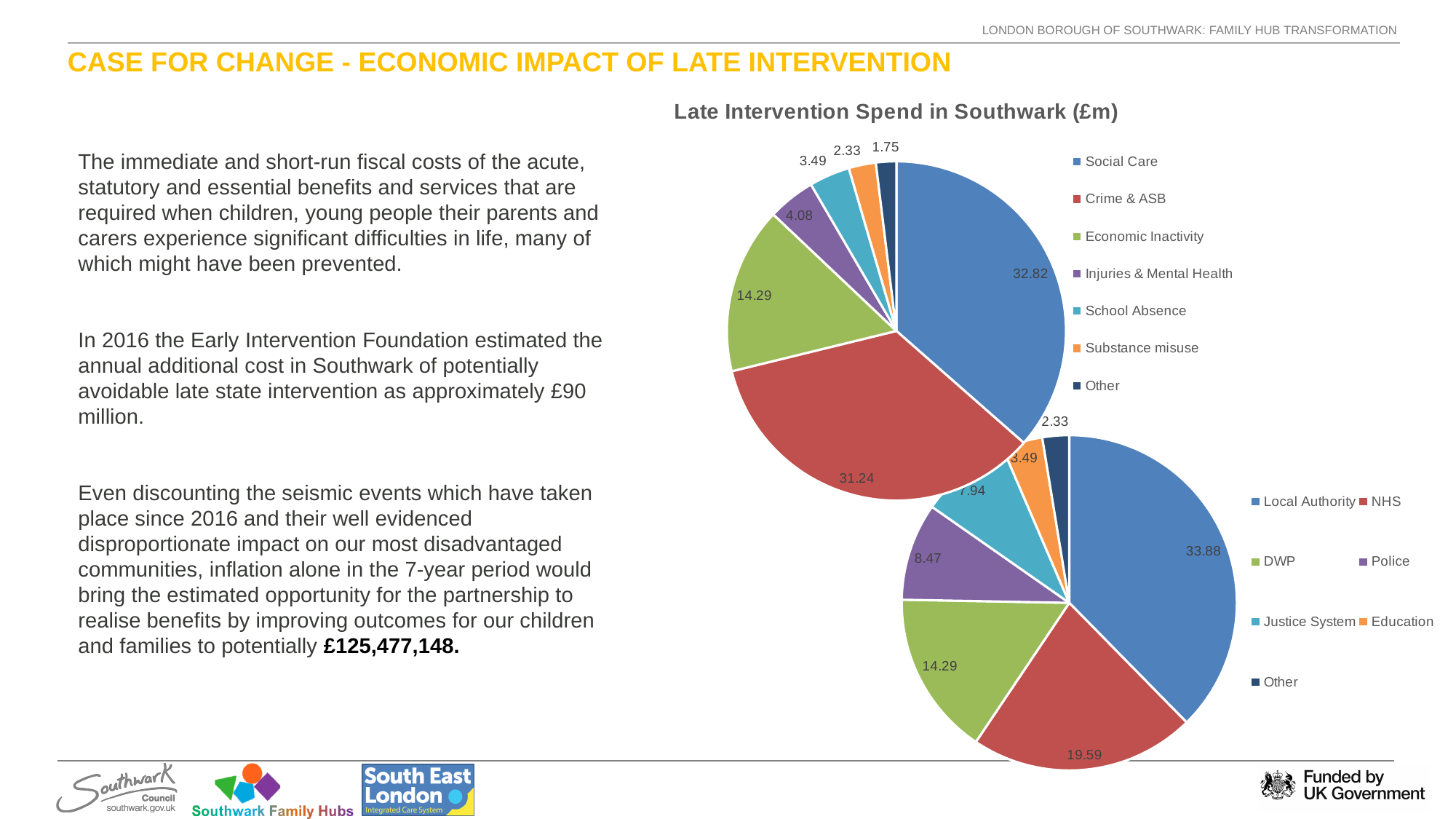
In the bottom-right pie chart (Local Authority, NHS, DWP...), what is the value for Local Authority? 33.88 In the top pie chart titled 'Late Intervention Spend in Southwark (£m)', what is the difference between Social Care and Crime & ASB? 1.58 In the bottom-right pie chart (Local Authority, NHS, DWP...), which is larger, NHS or DWP? NHS In the top pie chart titled 'Late Intervention Spend in Southwark (£m)', which category has the smallest slice? Other In the bottom-right pie chart (Local Authority, NHS, DWP...), which category has the smallest slice? Other In the top pie chart titled 'Late Intervention Spend in Southwark (£m)', what is the value for Social Care? 32.82 In the top pie chart titled 'Late Intervention Spend in Southwark (£m)', how many categories does the legend list? 7 In the top pie chart titled 'Late Intervention Spend in Southwark (£m)', what is the value for Economic Inactivity? 14.29 In the bottom-right pie chart (Local Authority, NHS, DWP...), what is the difference between Local Authority and NHS? 14.29 What kind of chart is the top chart titled 'Late Intervention Spend in Southwark (£m)'? Pie chart In the top pie chart titled 'Late Intervention Spend in Southwark (£m)', which category has the largest slice? Social Care In the bottom-right pie chart (Local Authority, NHS, DWP...), what is the value for Police? 8.47